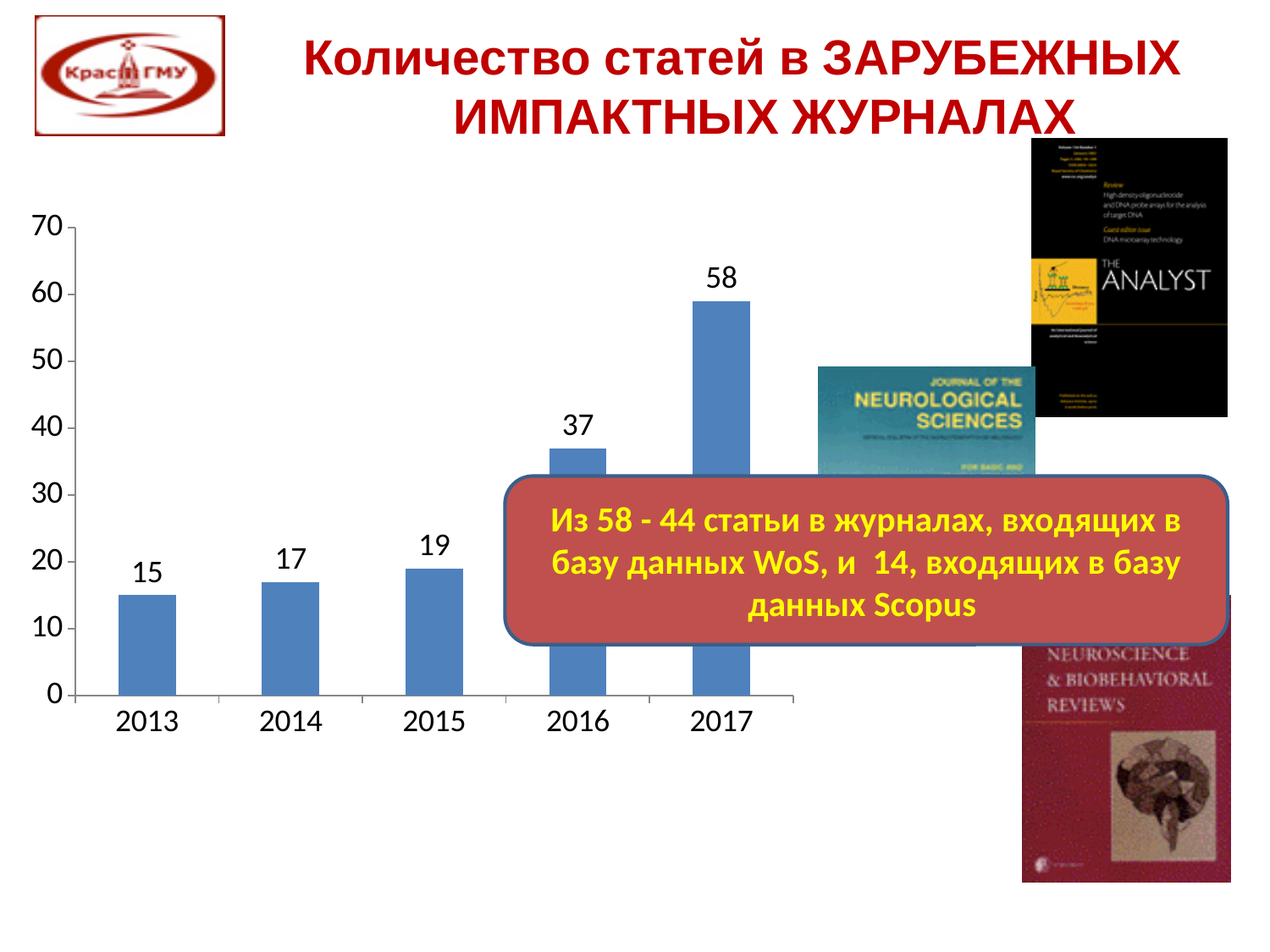
Do the values rise or fall from 2013 to 2017? rise Which year has the highest value? 2017 Which is larger, the value for 2016 or the value for 2015? 2016 What is the value for 2015? 19 What kind of chart is shown on the slide? bar chart How many years are shown on the x axis? 5 What is the value for 2013? 15 What is the difference between the values for 2015 and 2014? 2 What is the difference between the values for 2017 and 2016? 21 Which year has the lowest value? 2013 What is the value for 2017? 58 Is the value for 2016 greater or less than 30? greater